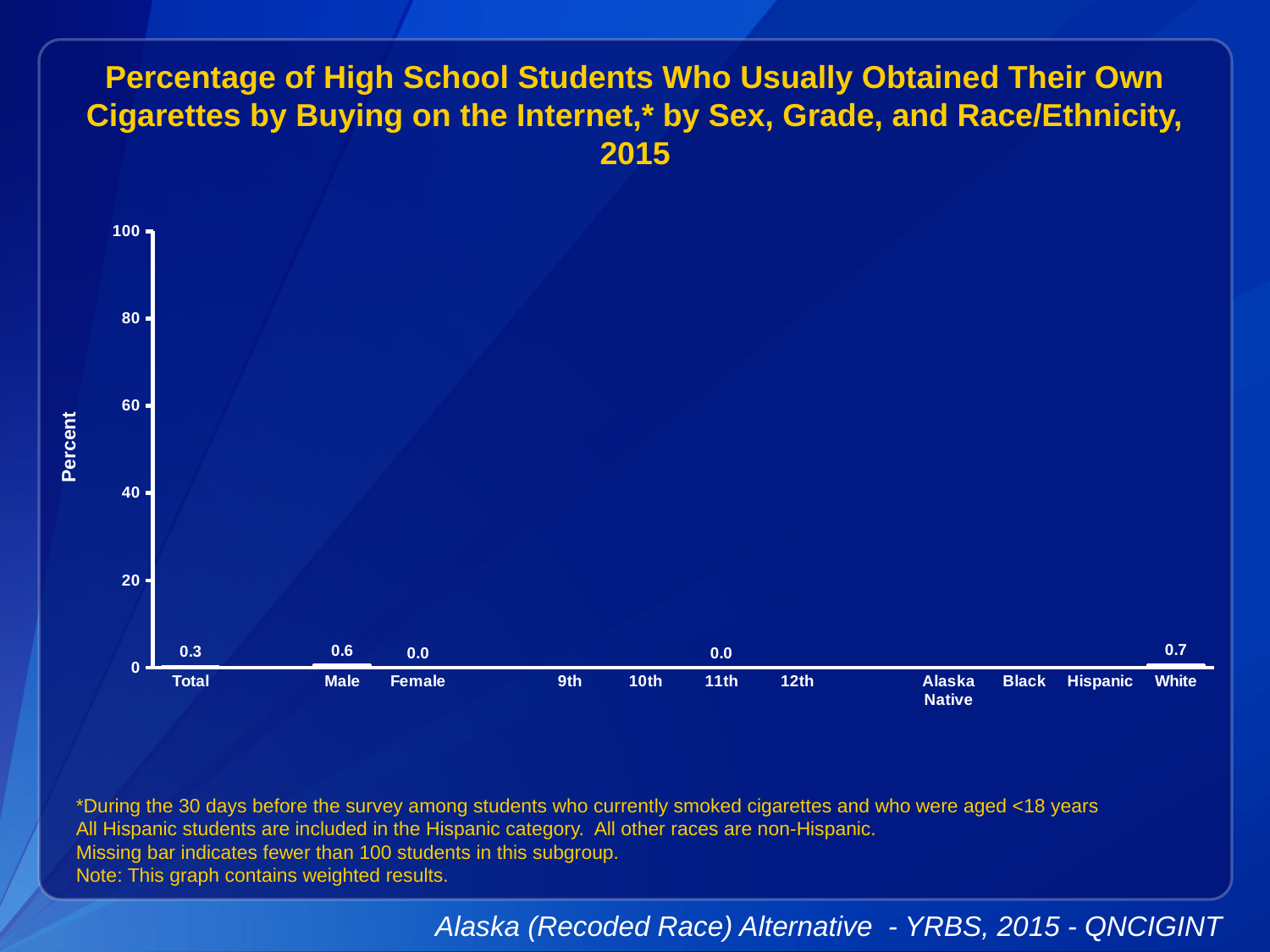
How many categories are labeled on the x axis? 11 What is the value for White? 0.7 Is the value for White greater or less than 20? less What is the difference between the values for Male and Total? 0.3 What is the value for Male? 0.6 What kind of chart is shown on the slide? bar chart What is the label of the y axis? Percent What is the value for 11th grade? 0.0 Which labeled category has the highest value? White What is the value for Total? 0.3 Which is larger, the value for Male or the value for Female? Male What is the value for Female? 0.0